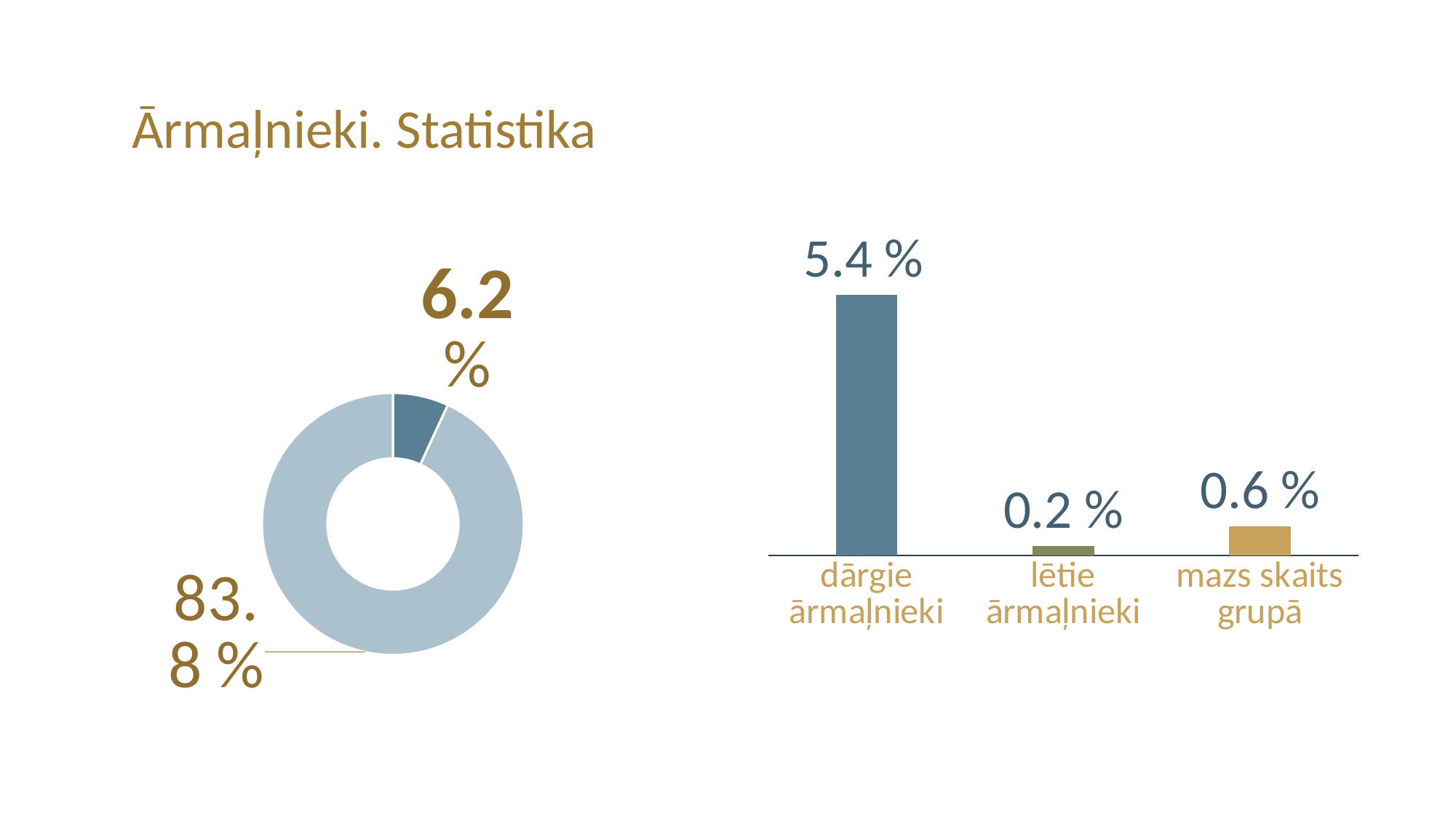
In the bar chart on the right, what is the value for lētie ārmaļnieki? 0.2 % In the bar chart on the right, which category has the highest value? dārgie ārmaļnieki In the bar chart on the right, what is the value for mazs skaits grupā? 0.6 % What kind of chart is shown on the right side of the slide? bar chart In the bar chart on the right, what is the difference between the values for dārgie ārmaļnieki and lētie ārmaļnieki? 5.2 % In the bar chart on the right, what is the value for dārgie ārmaļnieki? 5.4 % What kind of chart is shown on the left side of the slide? doughnut chart In the bar chart on the right, what is the difference between the values for dārgie ārmaļnieki and mazs skaits grupā? 4.8 % How many categories are shown in the bar chart on the right? 3 In the doughnut chart on the left, what value is labelled on the small dark slice? 6.2 % In the bar chart on the right, which is larger: lētie ārmaļnieki or mazs skaits grupā? mazs skaits grupā In the bar chart on the right, which category has the lowest value? lētie ārmaļnieki